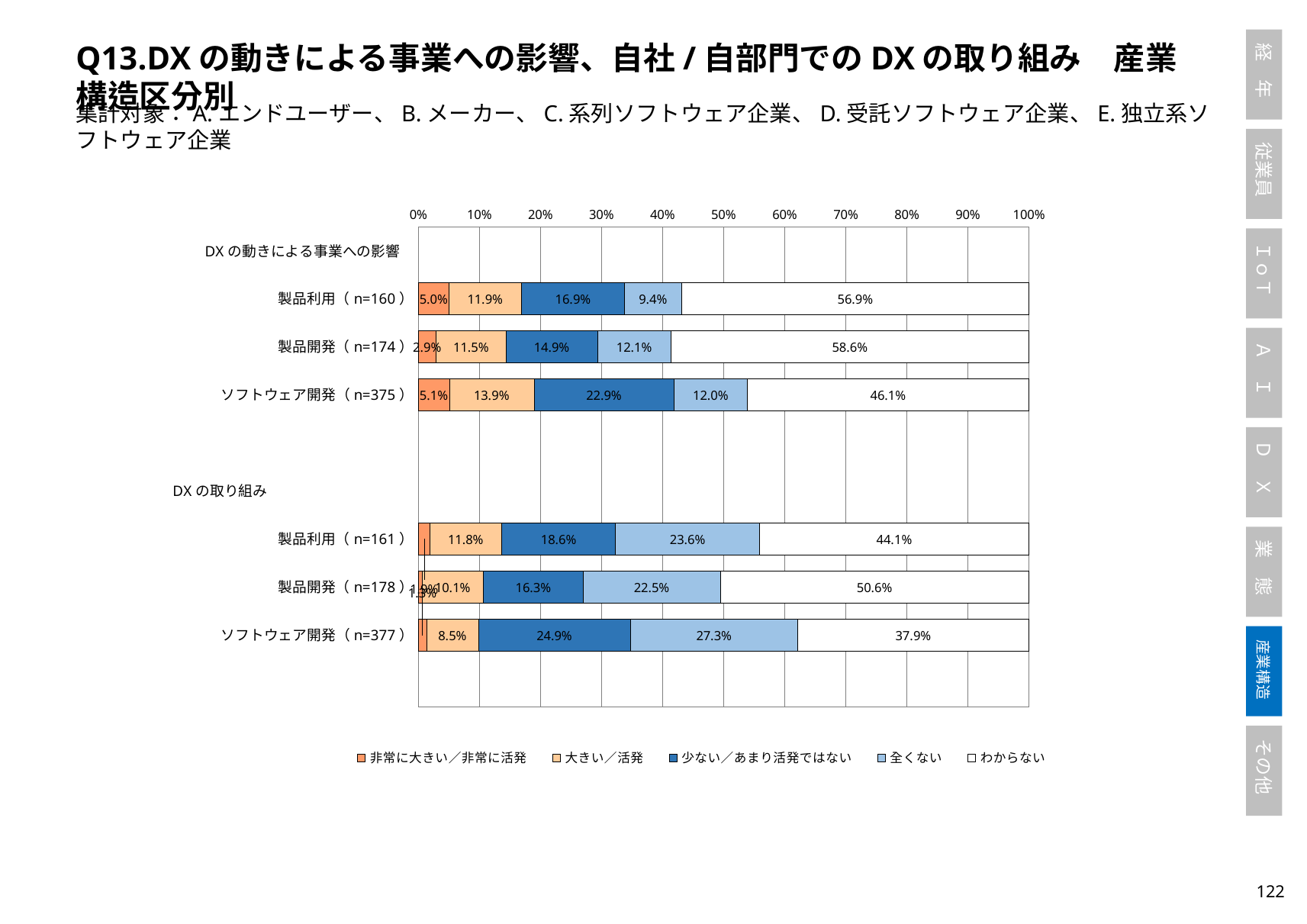
What type of chart is shown on the slide? Stacked horizontal bar chart What is the value of 少ない／あまり活発ではない for ソフトウェア開発 (n=375) under DX の動きによる事業への影響? 22.9% What is the value of 大きい／活発 for 製品開発 (n=178) under DX の取り組み? 10.1% How many series does the legend list? 5 Which is larger: the 全くない value for 製品利用 (n=161) or for 製品開発 (n=178) under DX の取り組み? 製品利用 (n=161) What is the difference between the わからない values for 製品利用 (n=160) and ソフトウェア開発 (n=375) under DX の動きによる事業への影響? 10.8% What is the value of 全くない for ソフトウェア開発 (n=377) under DX の取り組み? 27.3% Among the three rows under DX の動きによる事業への影響, which has the highest わからない value? 製品開発 (n=174) What is the value of わからない for 製品利用 (n=160) under DX の動きによる事業への影響? 56.9% How many bars (rows with data) are plotted in the chart? 6 Is the わからない value for 製品開発 (n=178) under DX の取り組み greater or less than 50%? greater Among the three rows under DX の取り組み, which has the lowest わからない value? ソフトウェア開発 (n=377)